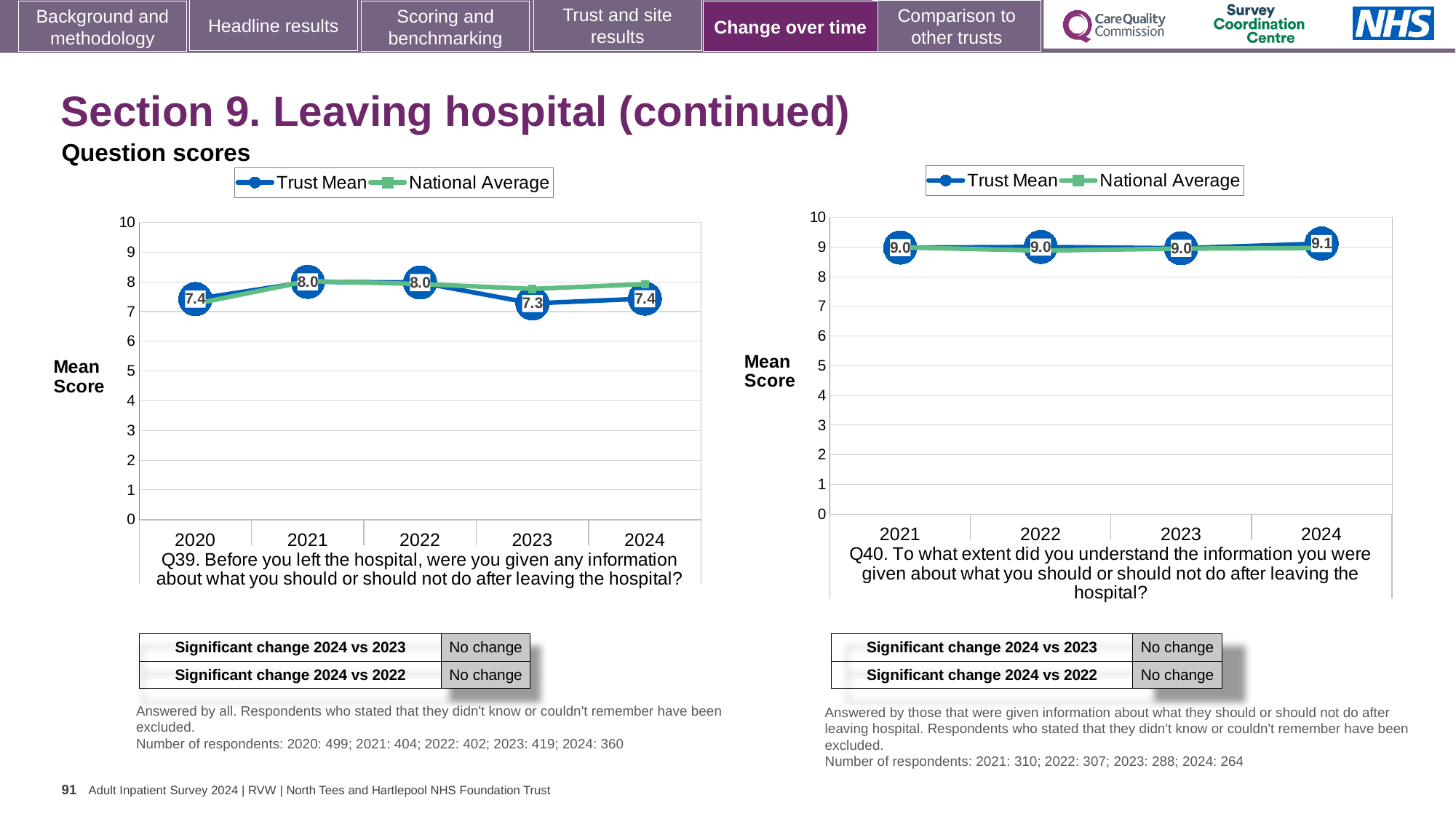
In the Q40 chart on the right, which year has the highest Trust Mean score? 2024 In the Q39 chart on the left, is the Trust Mean score for 2021 larger or smaller than the score for 2024? larger In the Q39 chart on the left, does the Trust Mean rise or fall from 2022 to 2023? fall In the Q39 chart on the left, what is the Trust Mean score for 2020? 7.4 How many series does the legend of the Q39 chart on the left list? 2 How many years are plotted on the x axis of the Q40 chart on the right? 4 In the Q39 chart on the left, what is the Trust Mean score for 2023? 7.3 In the Q39 chart on the left, which year has the lowest Trust Mean score? 2023 In the Q39 chart on the left, is the National Average value for 2024 greater or less than 7? greater In the Q39 chart on the left, what is the difference between the Trust Mean scores for 2022 and 2023? 0.7 What type of chart is used for Q40 on the right? Line chart In the Q40 chart on the right, what is the Trust Mean score for 2024? 9.1